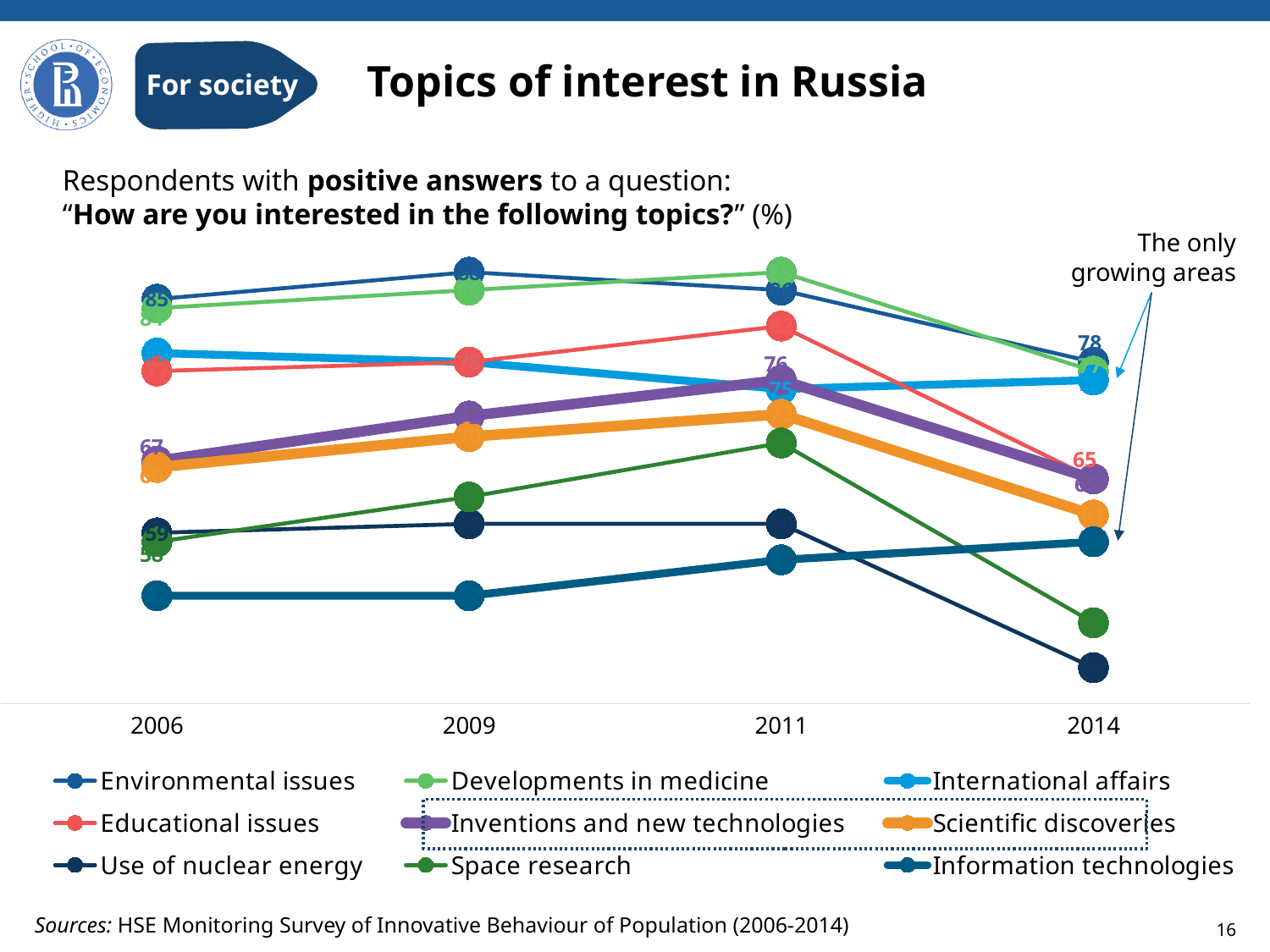
What is the value for Inventions and new technologies in 2011? 76 Does the value for Space research rise or fall from 2011 to 2014? fall How many years are shown on the x axis? 4 What is the value for Environmental issues in 2014? 78 What is the value for Educational issues in 2014? 65 By how much did the value for Environmental issues fall from 2006 to 2014? 7 What is the value for Environmental issues in 2006? 85 How many series does the legend list? 9 Which topic has the lowest value in 2006? Information technologies Which topic has the lowest value in 2014? Use of nuclear energy What kind of chart is shown on the slide? line chart What is the value for International affairs in 2011? 75